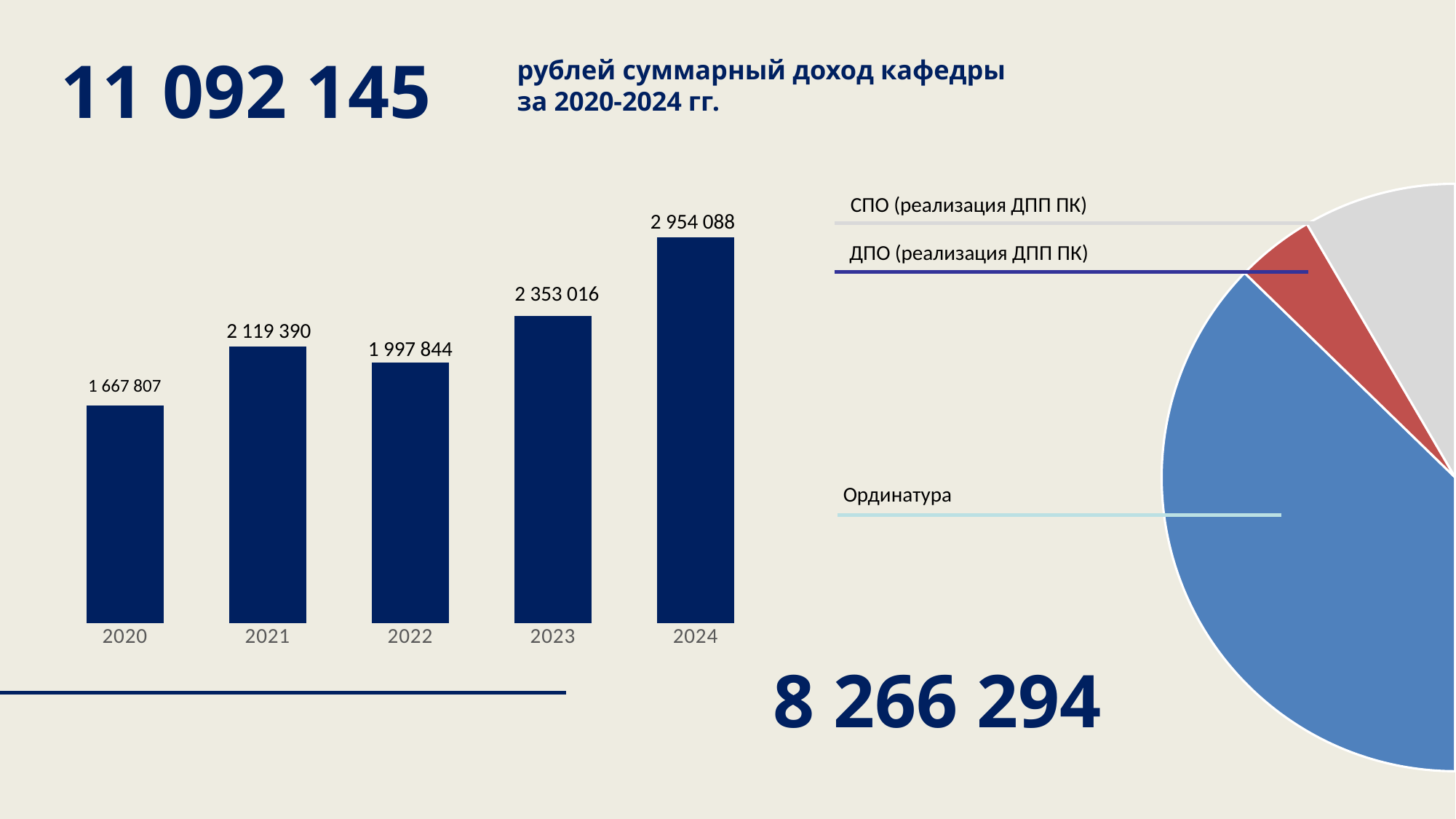
In the bar chart on the left, what is the value for 2024? 2 954 088 In the bar chart on the left, which year has the highest value? 2024 In the bar chart on the left, do the values generally rise or fall from 2020 to 2024? rise, with a dip in 2022 In the bar chart on the left, what is the value for 2022? 1 997 844 What kind of chart is on the left of the slide? bar chart In the bar chart on the left, which year has the lowest value? 2020 In the bar chart on the left, what is the difference between the values for 2021 and 2022? 121 546 How many years are shown in the bar chart on the left? 5 In the bar chart on the left, what is the difference between the values for 2024 and 2023? 601 072 In the bar chart on the left, what is the value for 2020? 1 667 807 In the bar chart on the left, which is larger, the value for 2021 or the value for 2022? 2021